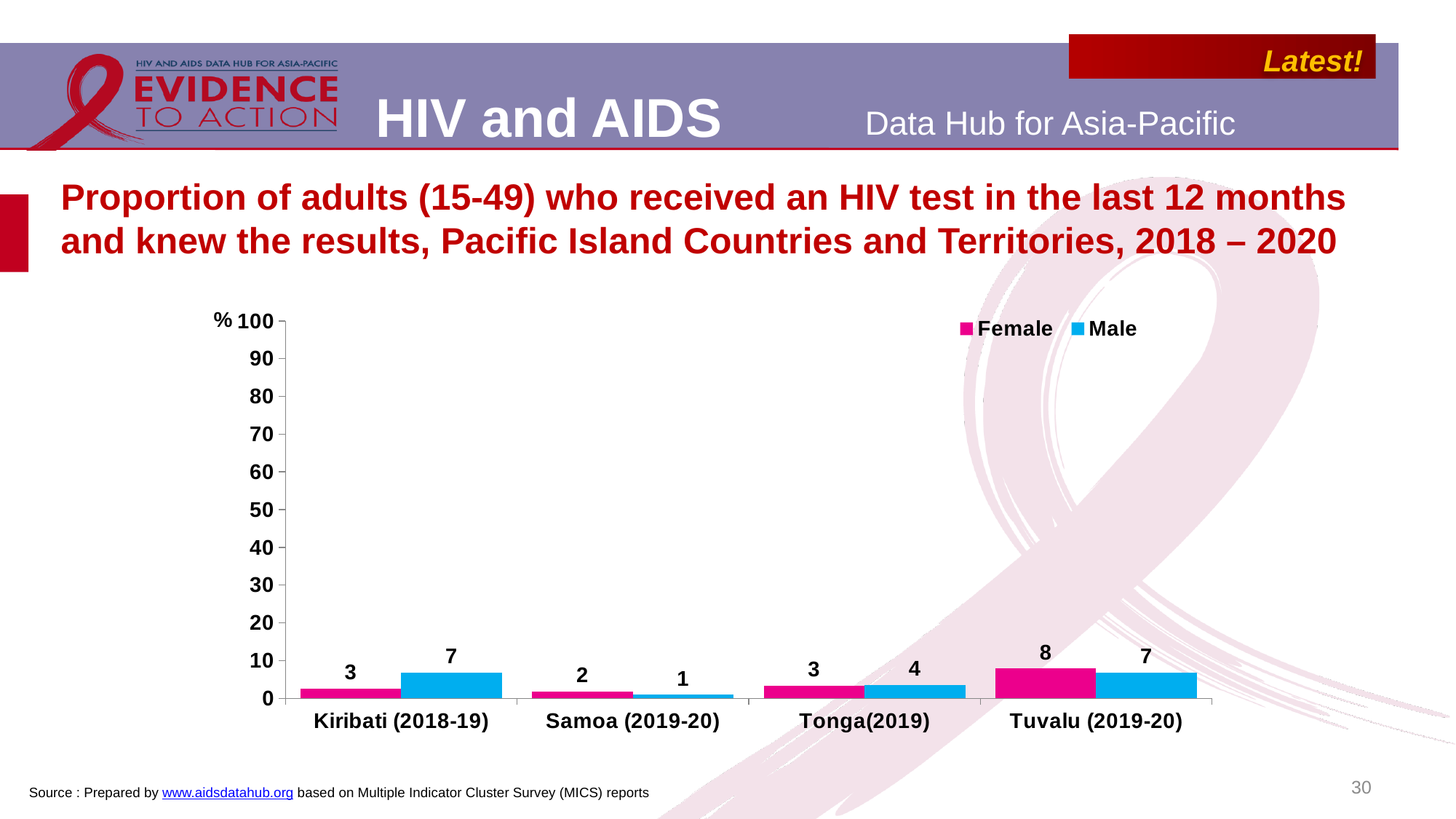
Which colour represents the Male series? Blue What is the difference between the Male and Female values for Kiribati (2018-19)? 4 Is the Female value or the Male value larger for Tuvalu (2019-20)? Female What is the Male value for Samoa (2019-20)? 1 What is the Female value for Tuvalu (2019-20)? 8 What is the Male value for Tonga(2019)? 4 What is the Female value for Kiribati (2018-19)? 3 Which country has the lowest Male value? Samoa (2019-20) Which country has the highest Female value? Tuvalu (2019-20) What kind of chart is shown on the slide? Bar chart How many series does the legend list? 2 How many countries are shown on the x axis? 4